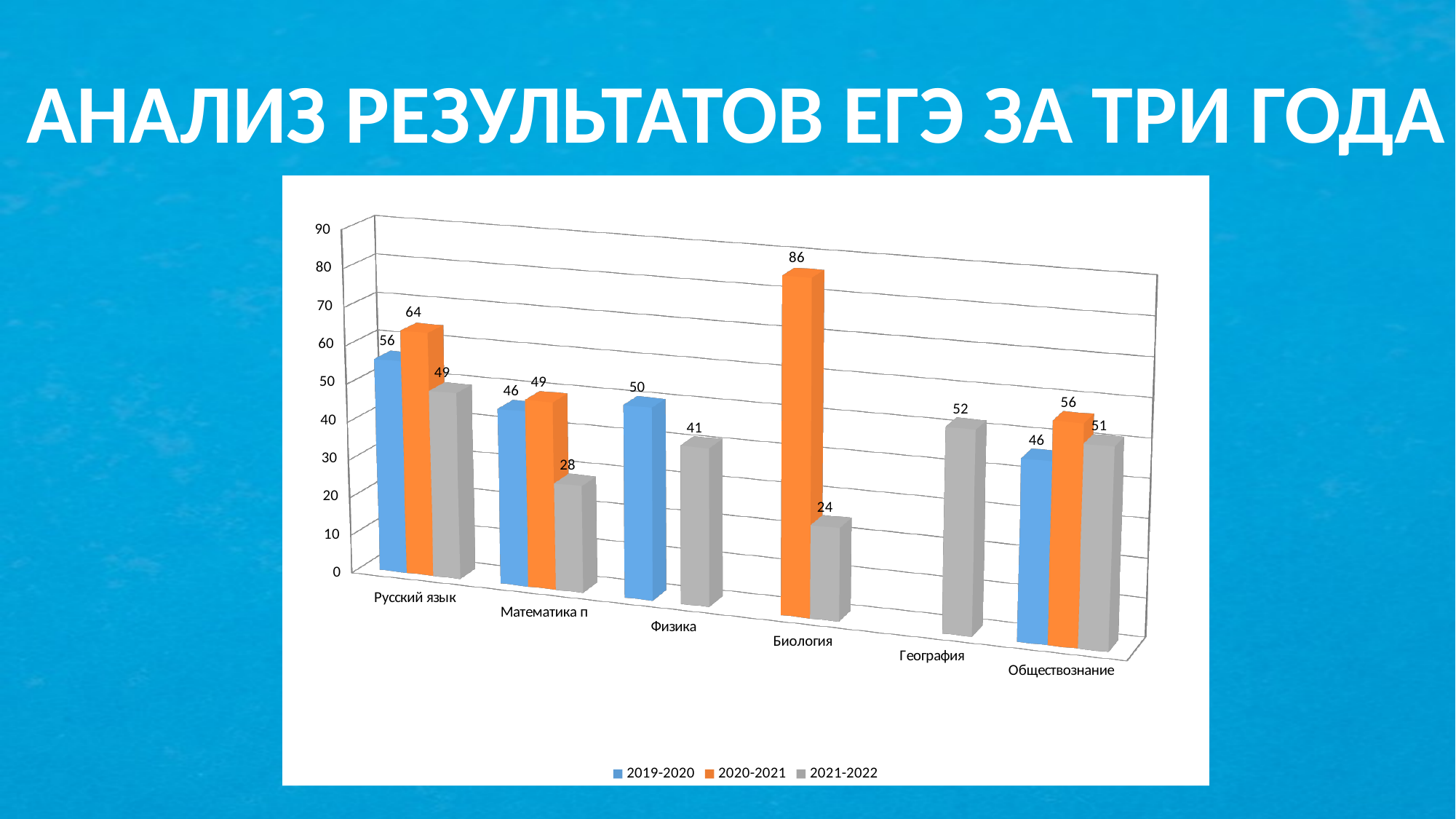
How many series does the legend list? 3 What is the value for Физика in the 2019-2020 series? 50 Which series is shown in orange in the legend? 2020-2021 Which category has the lowest value in the 2021-2022 series? Биология Which category has the highest value in the 2020-2021 series? Биология What is the value for Русский язык in the 2020-2021 series? 64 How many categories are shown on the x axis? 6 What is the difference between the 2020-2021 and 2021-2022 values for Биология? 62 Which is larger for Математика п: the 2020-2021 value or the 2021-2022 value? 2020-2021 What kind of chart is shown on the slide? Bar chart What is the value for Биология in the 2021-2022 series? 24 What is the difference between the 2019-2020 and 2020-2021 values for Обществознание? 10